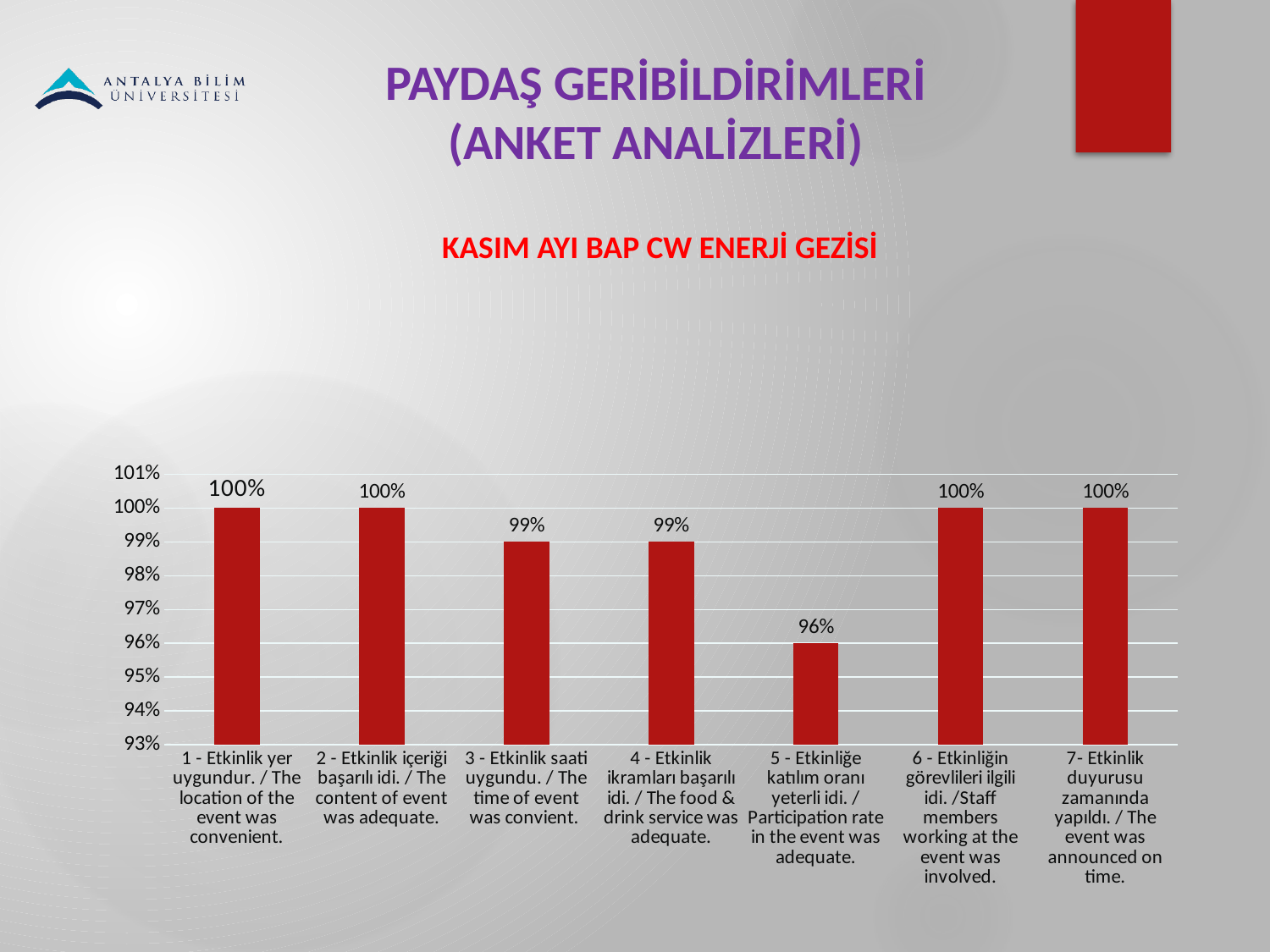
What is the value for category 5 (Participation rate in the event was adequate)? 96% What is the value for category 3 (The time of event was convient)? 99% What is the value for category 1 (The location of the event was convenient)? 100% How many categories are shown in the chart? 7 Is the value for category 5 greater or less than 97%? less Which is larger, the value for category 2 or the value for category 3? Category 2 (100%) How many categories have a value of 100%? 4 What is the difference between the value for category 4 and the value for category 5? 3% What is the title shown above the chart? KASIM AYI BAP CW ENERJİ GEZİSİ Which category has the lowest value? 5 - Etkinliğe katılım oranı yeterli idi. / Participation rate in the event was adequate. What kind of chart is shown on the slide? Bar chart What is the difference between the value for category 1 and the value for category 5? 4%